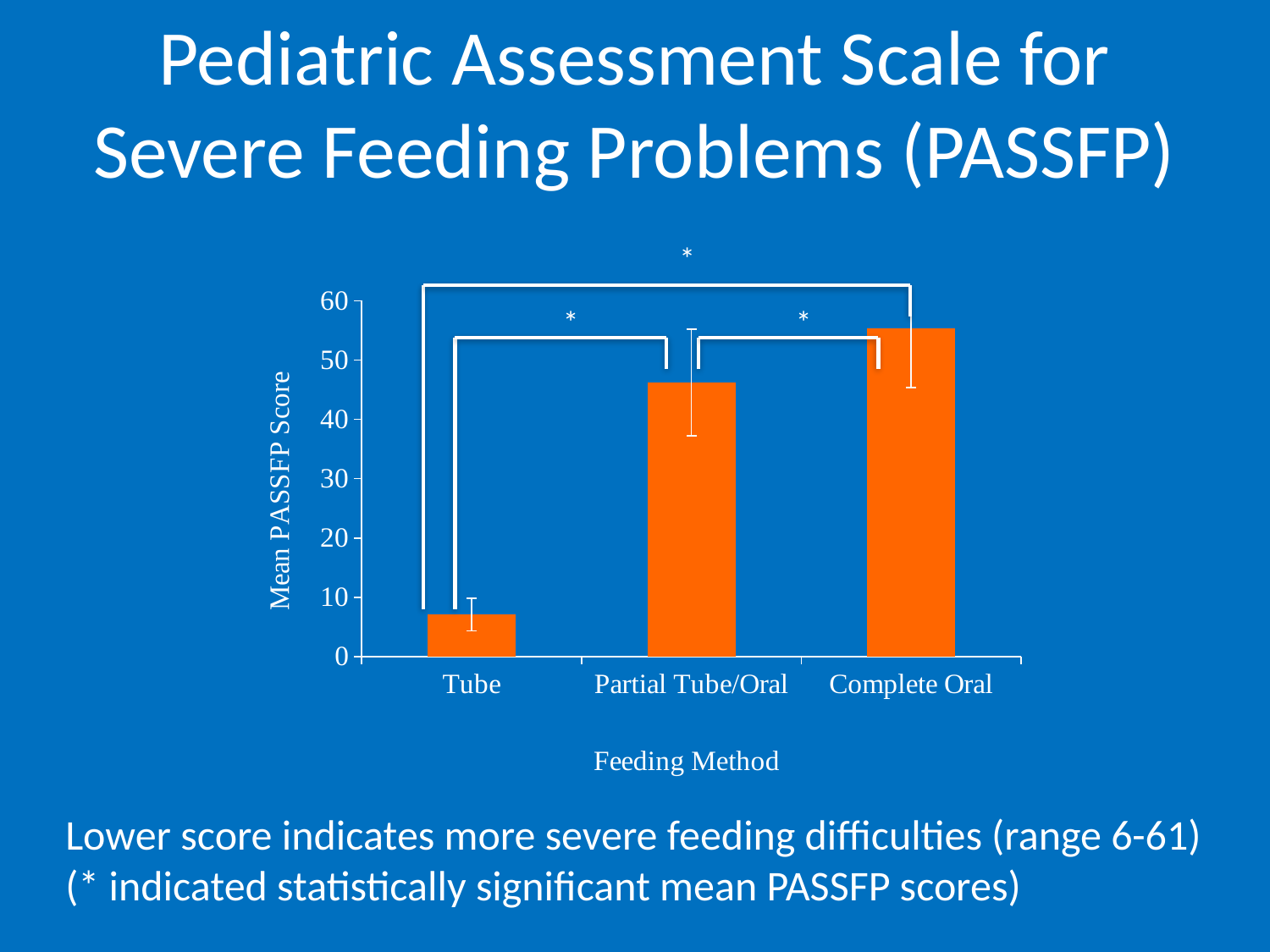
Which has a larger mean PASSFP score, Partial Tube/Oral or Complete Oral? Complete Oral How many feeding method categories are plotted on the chart? 3 Is the mean PASSFP score for Tube greater or less than 10? less Is the mean PASSFP score for Complete Oral greater or less than 50? greater Do the mean PASSFP scores rise or fall moving from Tube to Complete Oral along the x axis? rise Which feeding method has the lowest mean PASSFP score? Tube Is the mean PASSFP score for Partial Tube/Oral greater or less than 40? greater What is the label of the horizontal axis of the chart? Feeding Method What kind of chart is shown on the slide? bar chart Which feeding method has the highest mean PASSFP score? Complete Oral What is the label of the vertical axis of the chart? Mean PASSFP Score Which has a larger mean PASSFP score, Tube or Partial Tube/Oral? Partial Tube/Oral